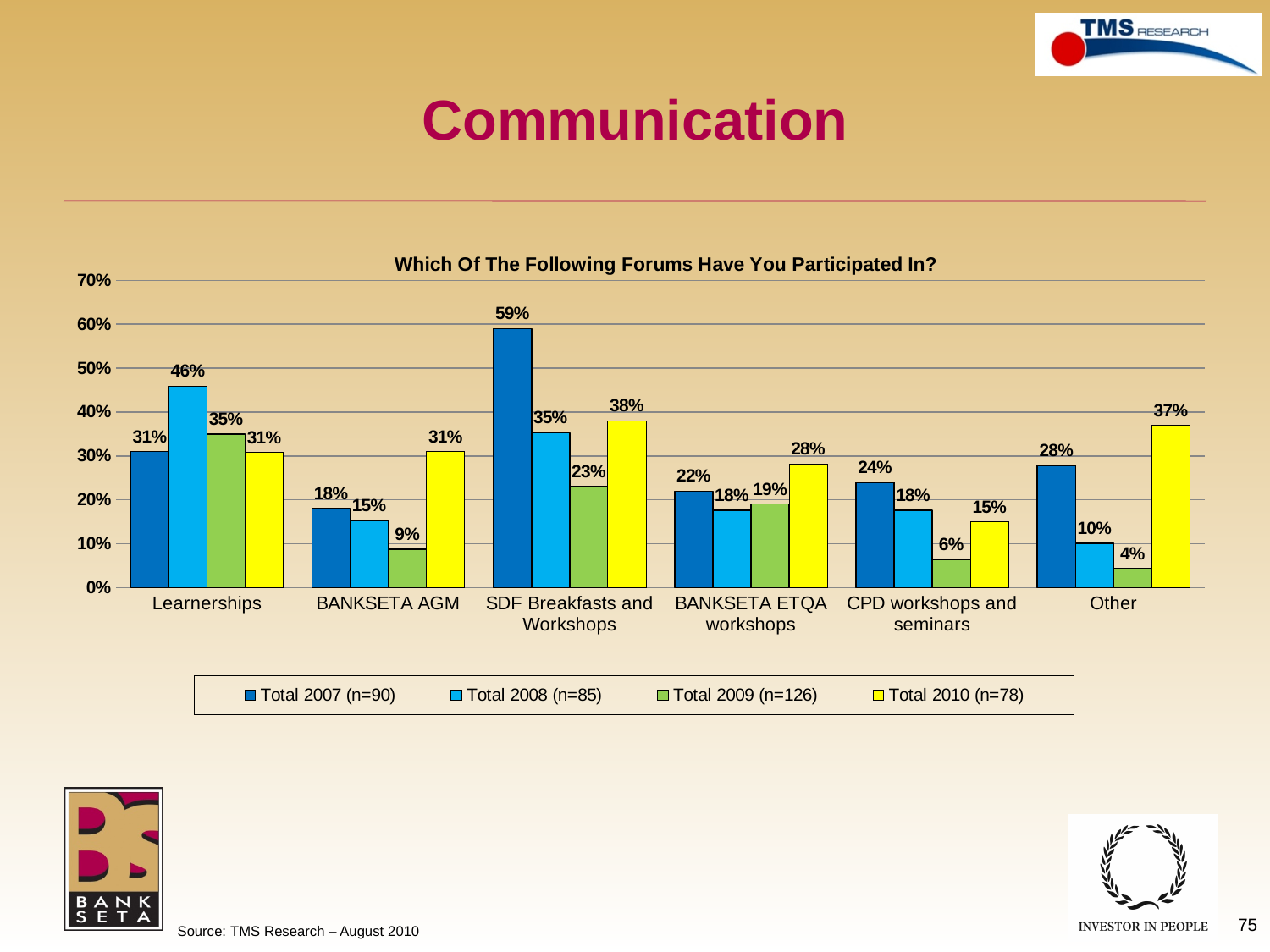
Which category has the highest value for Total 2008 (n=85)? Learnerships Is the value for Total 2008 (n=85) for Learnerships greater or less than 40%? greater What kind of chart is shown on the slide? Bar chart What is the value for Total 2009 (n=126) for BANKSETA AGM? 9% What is the title of the chart? Which Of The Following Forums Have You Participated In? Which is larger for CPD workshops and seminars: Total 2007 (n=90) or Total 2010 (n=78)? Total 2007 (n=90) Which category has the lowest value for Total 2009 (n=126)? Other How many categories are shown on the x axis? 6 How many series does the legend list? 4 What is the value for Total 2007 (n=90) for SDF Breakfasts and Workshops? 59% What is the value for Total 2010 (n=78) for Other? 37% What is the difference between the Total 2007 (n=90) and Total 2010 (n=78) values for SDF Breakfasts and Workshops? 21%